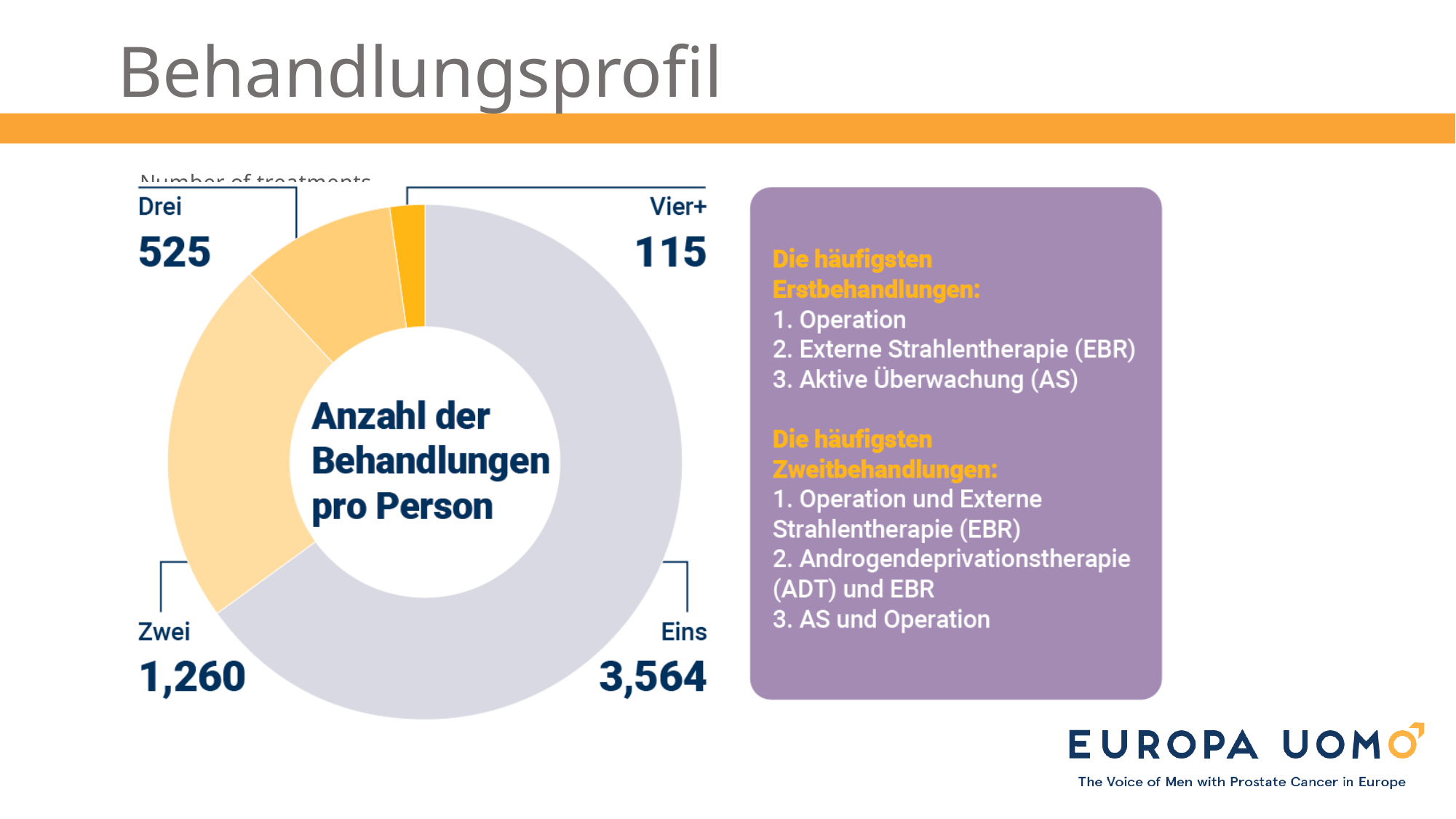
What is the value for Vier+ in the donut chart? 115 What is the value for Zwei in the donut chart? 1,260 Which is larger, the value for Drei or the value for Vier+? Drei What is the total of all four values shown in the donut chart? 5,464 What is the value for Drei in the donut chart? 525 How many categories are shown in the donut chart? 4 Which category has the lowest value in the donut chart? Vier+ What kind of chart is shown on the slide? Donut (pie) chart What is the value for Eins in the donut chart? 3,564 Which category has the highest value in the donut chart? Eins What text is written in the centre of the donut chart? Anzahl der Behandlungen pro Person What is the difference between the values for Eins and Zwei? 2,304